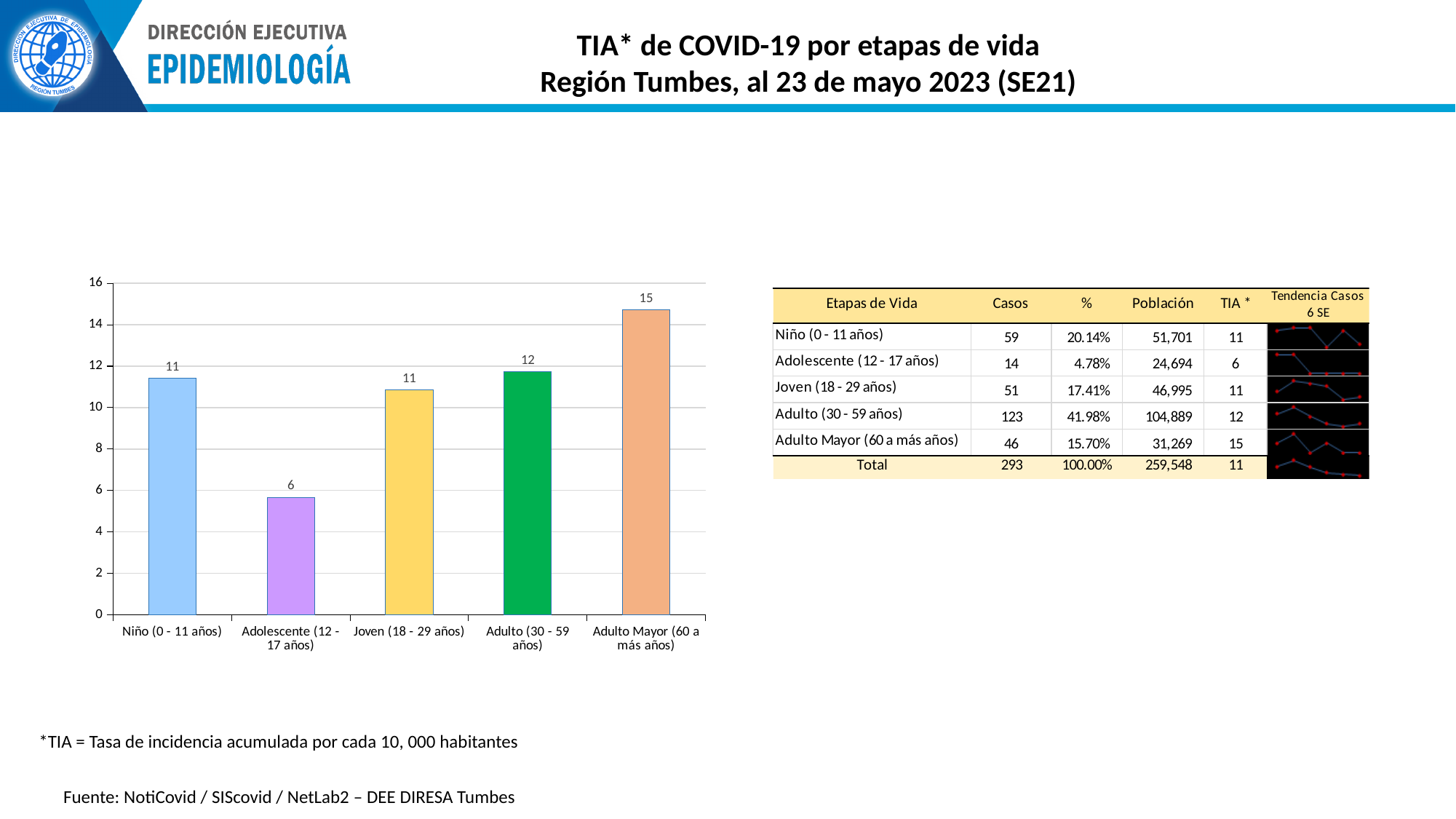
What is the difference between the TIA labels for Adulto Mayor (60 a más años) and Adolescente (12 - 17 años)? 9 How many age-stage categories are plotted in the bar chart? 5 What is the TIA value shown for Adulto Mayor (60 a más años) in the bar chart? 15 Which has a larger TIA in the bar chart, Adulto (30 - 59 años) or Adolescente (12 - 17 años)? Adulto (30 - 59 años) Which age stage has the highest TIA in the bar chart? Adulto Mayor (60 a más años) Is the bar for Adulto Mayor (60 a más años) greater or less than 14? greater What is the TIA value shown for Adulto (30 - 59 años) in the bar chart? 12 What is the TIA value shown for Adolescente (12 - 17 años) in the bar chart? 6 Which age stage has the lowest TIA in the bar chart? Adolescente (12 - 17 años) What is the TIA value shown for Niño (0 - 11 años) in the bar chart? 11 What is the title of the chart on the slide? TIA* de COVID-19 por etapas de vida Región Tumbes, al 23 de mayo 2023 (SE21) What type of chart is shown on the slide? bar chart